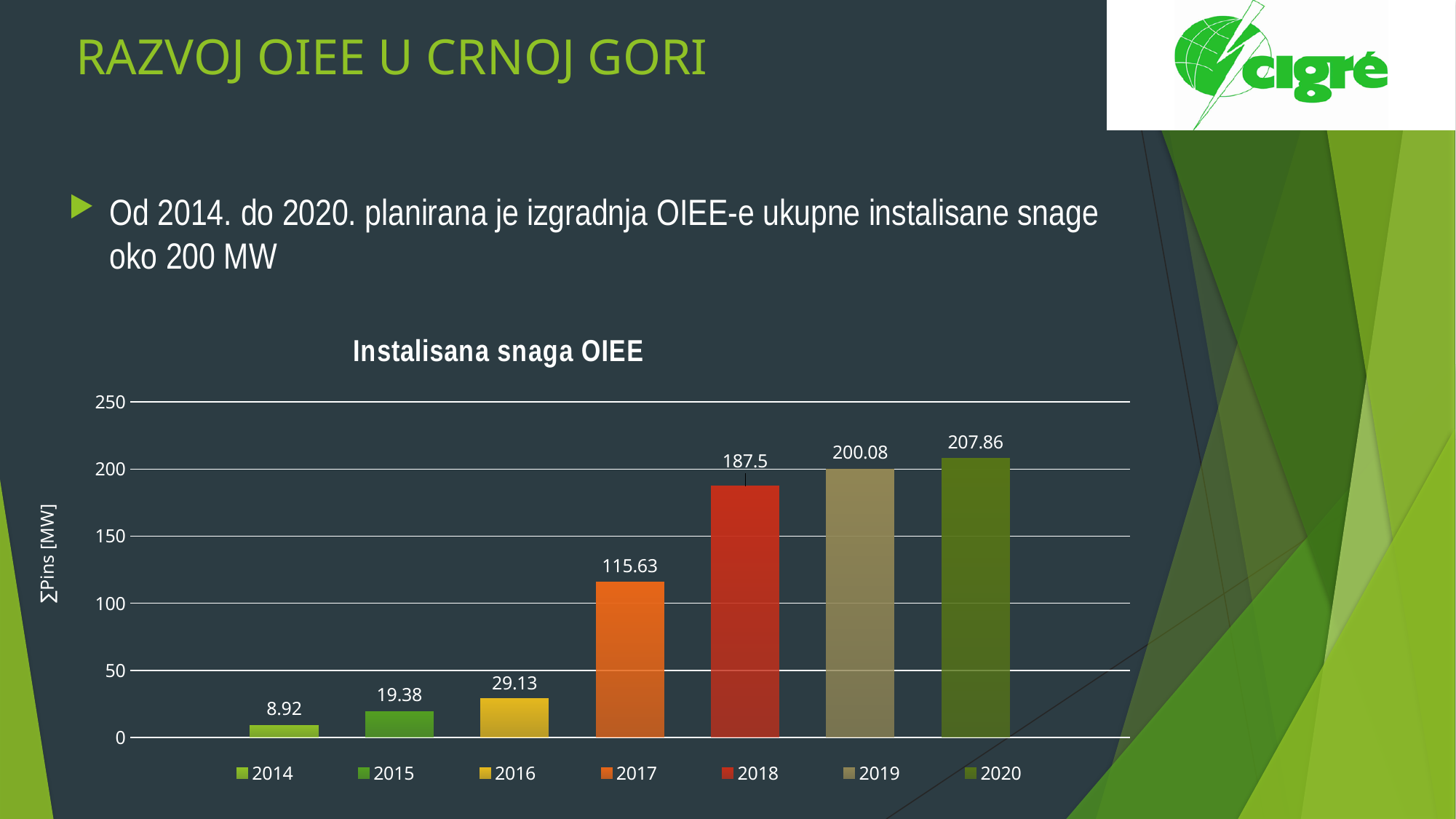
Which year has the lowest value in the chart? 2014 How many bars are plotted in the chart? 7 Do the values rise or fall from 2014 to 2020? rise Which is larger, the value for 2016 or the value for 2015? 2016 What is the installed capacity value shown for 2017 in the chart? 115.63 What value is labelled on the 2014 bar? 8.92 Is the value for 2018 greater or less than 150? greater What value is shown for 2019? 200.08 Which year has the highest value in the chart? 2020 What is the difference between the values for 2020 and 2019? 7.78 What kind of chart is shown on the slide? bar chart What is the difference between the values for 2018 and 2017? 71.87